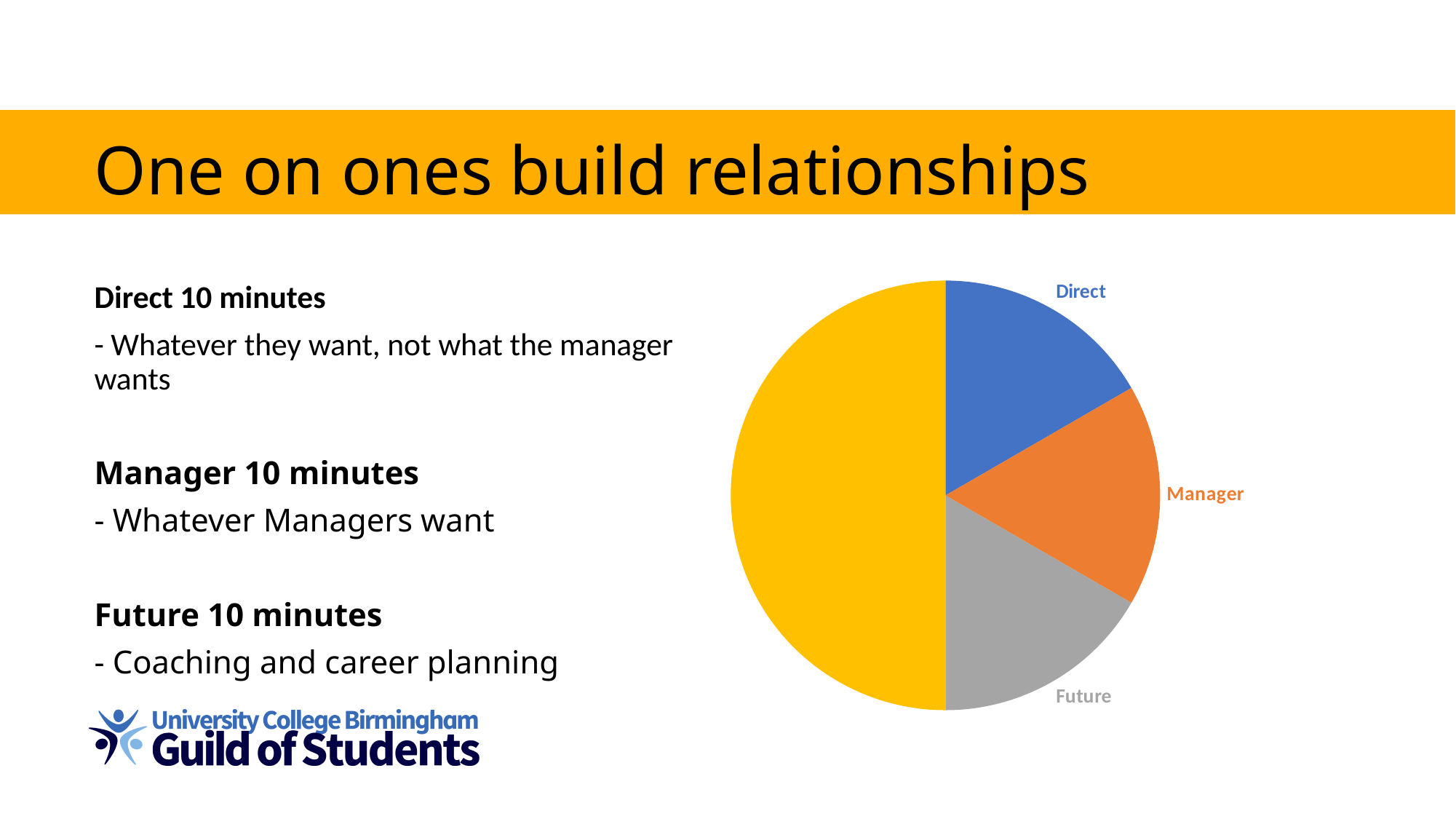
Is the Future slice larger or smaller than the unlabelled yellow slice? smaller How many slices does the pie chart have in total? 4 Does the Manager slice take up more or less than a quarter of the pie? less How many slices of the pie chart have a text label? 3 What kind of chart is shown on the slide? pie chart Does the unlabelled yellow slice take up more or less than a quarter of the pie? more Is the Direct slice larger or smaller than the unlabelled yellow slice? smaller What are the three labelled slices of the pie chart? Direct, Manager, Future Which colour is the largest slice of the pie chart? yellow